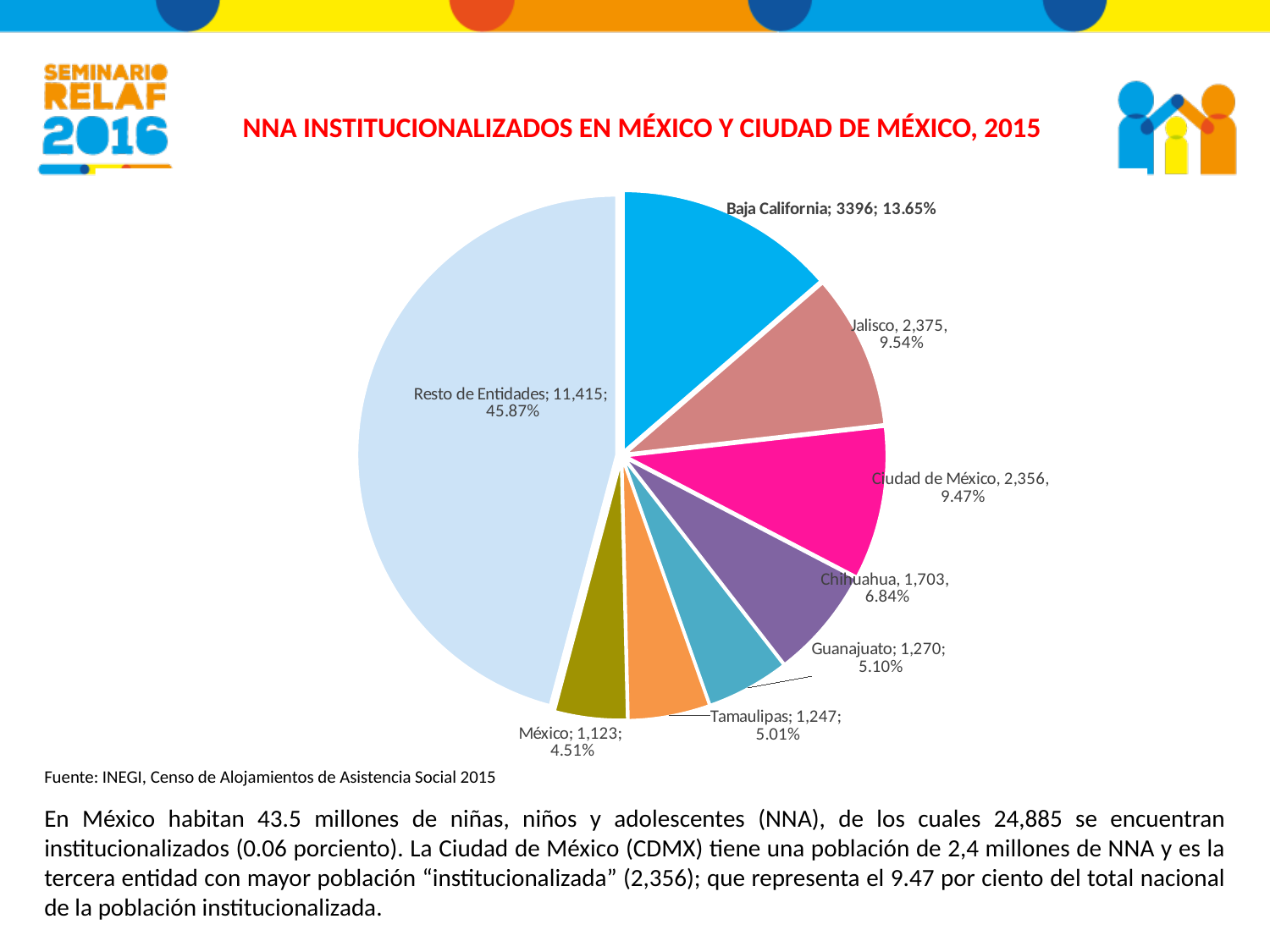
What percentage share does Resto de Entidades have in the pie chart? 45.87% Which has a larger value, Guanajuato or Tamaulipas? Guanajuato What is the value shown for Tamaulipas? 1,247 What is the title of the slide containing the pie chart? NNA INSTITUCIONALIZADOS EN MÉXICO Y CIUDAD DE MÉXICO, 2015 Which slice of the pie chart is the smallest? México What is the value shown for Chihuahua? 1,703 What is the value shown for Baja California? 3396 How many slices does the pie chart have? 8 What is the difference between the values for Jalisco and Ciudad de México? 19 What percentage share does Ciudad de México have in the pie chart? 9.47% Which slice of the pie chart is the largest? Resto de Entidades What kind of chart is shown on the slide? Pie chart